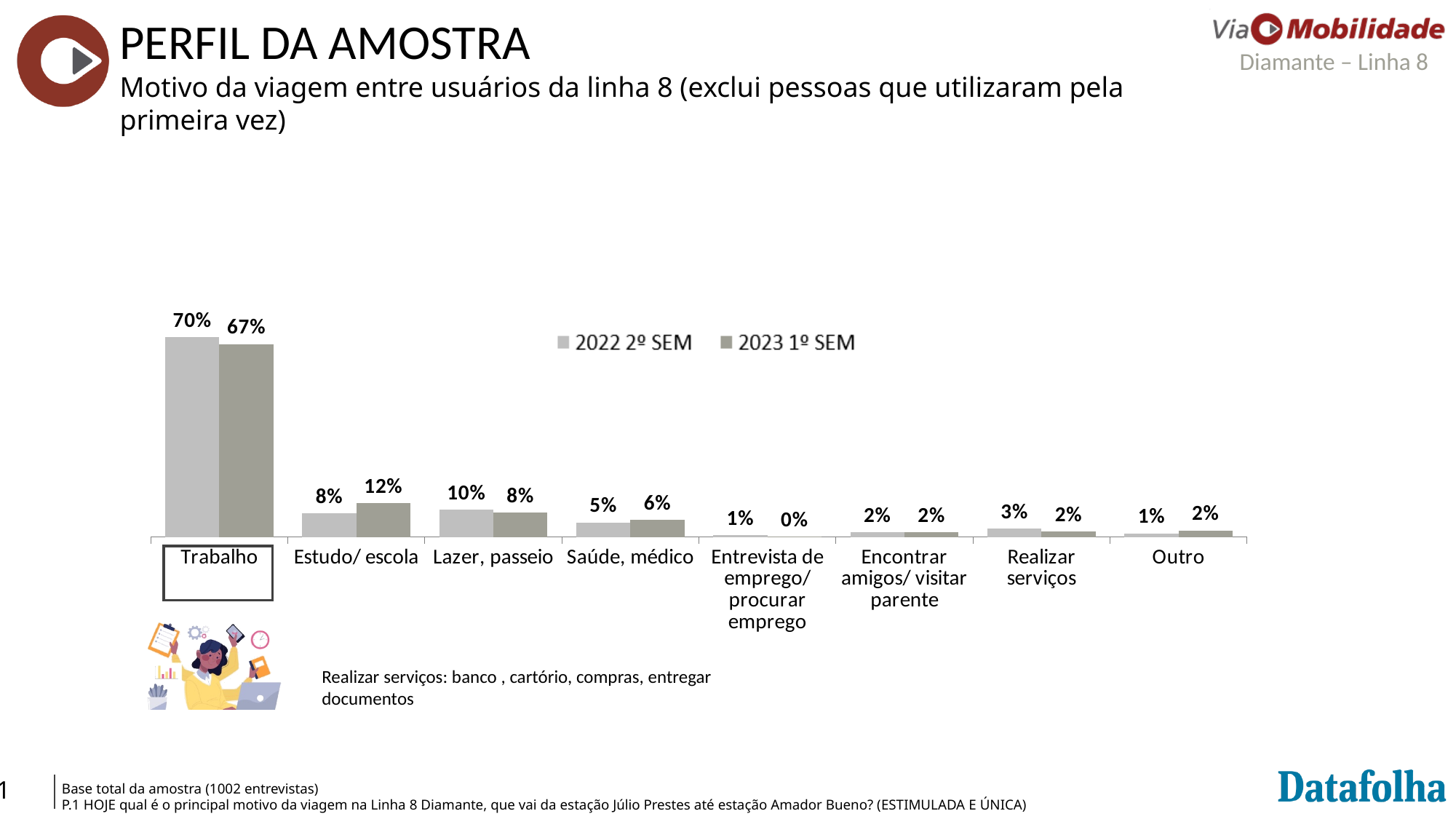
What is the value for Trabalho in the 2022 2º SEM series? 70% How many series does the legend list? 2 What is the value for Estudo/ escola in the 2023 1º SEM series? 12% What kind of chart is shown on the slide? Bar chart What are the two series named in the legend? 2022 2º SEM and 2023 1º SEM Which category has the highest value in the 2023 1º SEM series? Trabalho How many categories are shown on the x axis? 8 What is the difference between the 2022 2º SEM and 2023 1º SEM values for Trabalho? 3% What is the value for Entrevista de emprego/ procurar emprego in the 2023 1º SEM series? 0% What is the difference between the 2023 1º SEM and 2022 2º SEM values for Estudo/ escola? 4% Which category has the lowest value in the 2022 2º SEM series? Entrevista de emprego/ procurar emprego and Outro (both 1%) Which is larger for Lazer, passeio: the 2022 2º SEM value or the 2023 1º SEM value? 2022 2º SEM